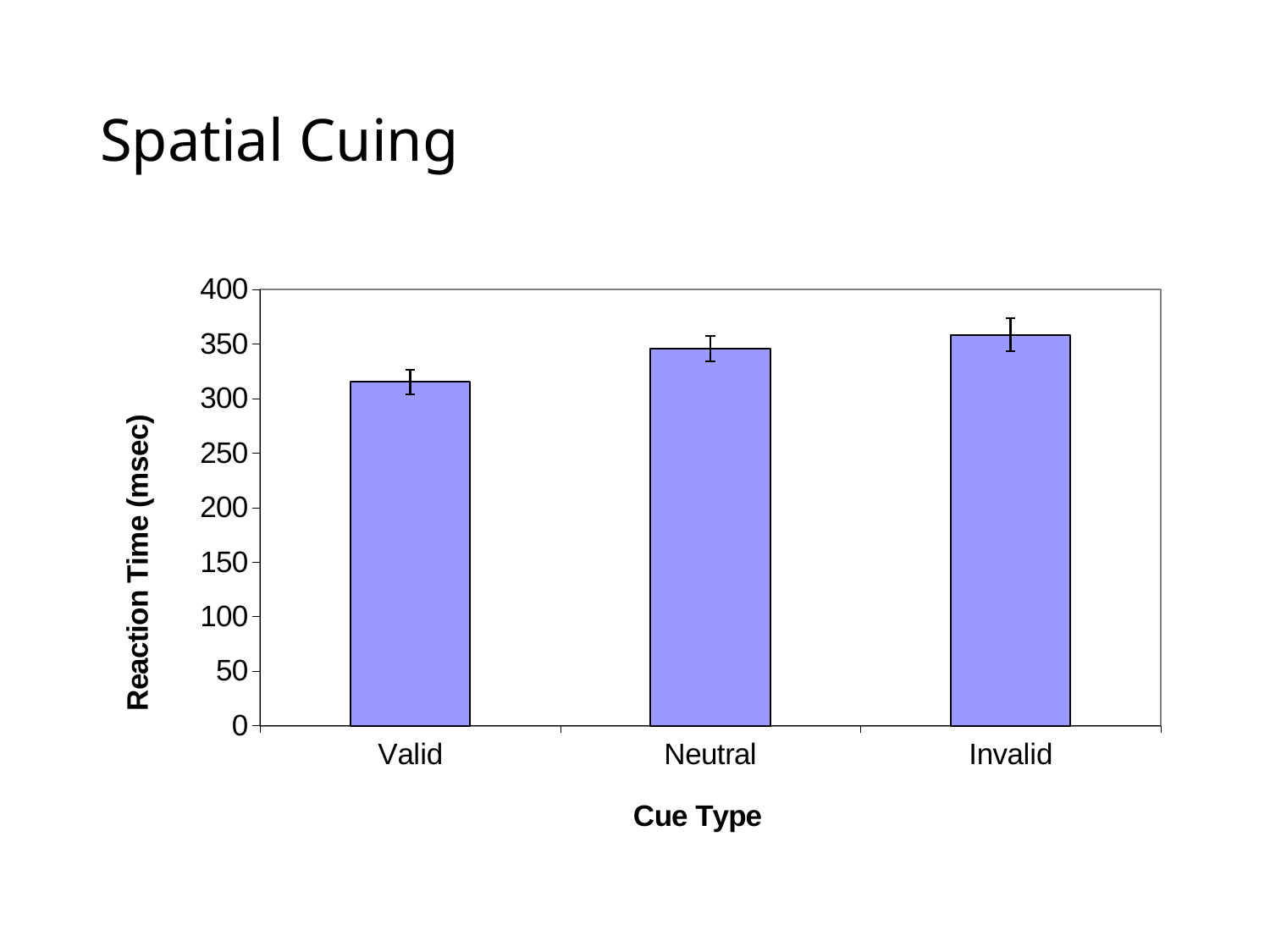
Which cue type has the lowest reaction time? Valid Is the reaction time for Valid greater or less than 350? less How many cue types are plotted on the chart? 3 Do the reaction times rise or fall from Valid to Invalid along the x axis? rise What is the label of the vertical axis? Reaction Time (msec) Which has a larger reaction time, Valid or Neutral? Neutral Which cue type has the highest reaction time? Invalid Is the reaction time for Invalid greater or less than 400? less Is the reaction time for Neutral greater or less than 300? greater Which has a larger reaction time, Valid or Invalid? Invalid What kind of chart is shown on the slide? bar chart